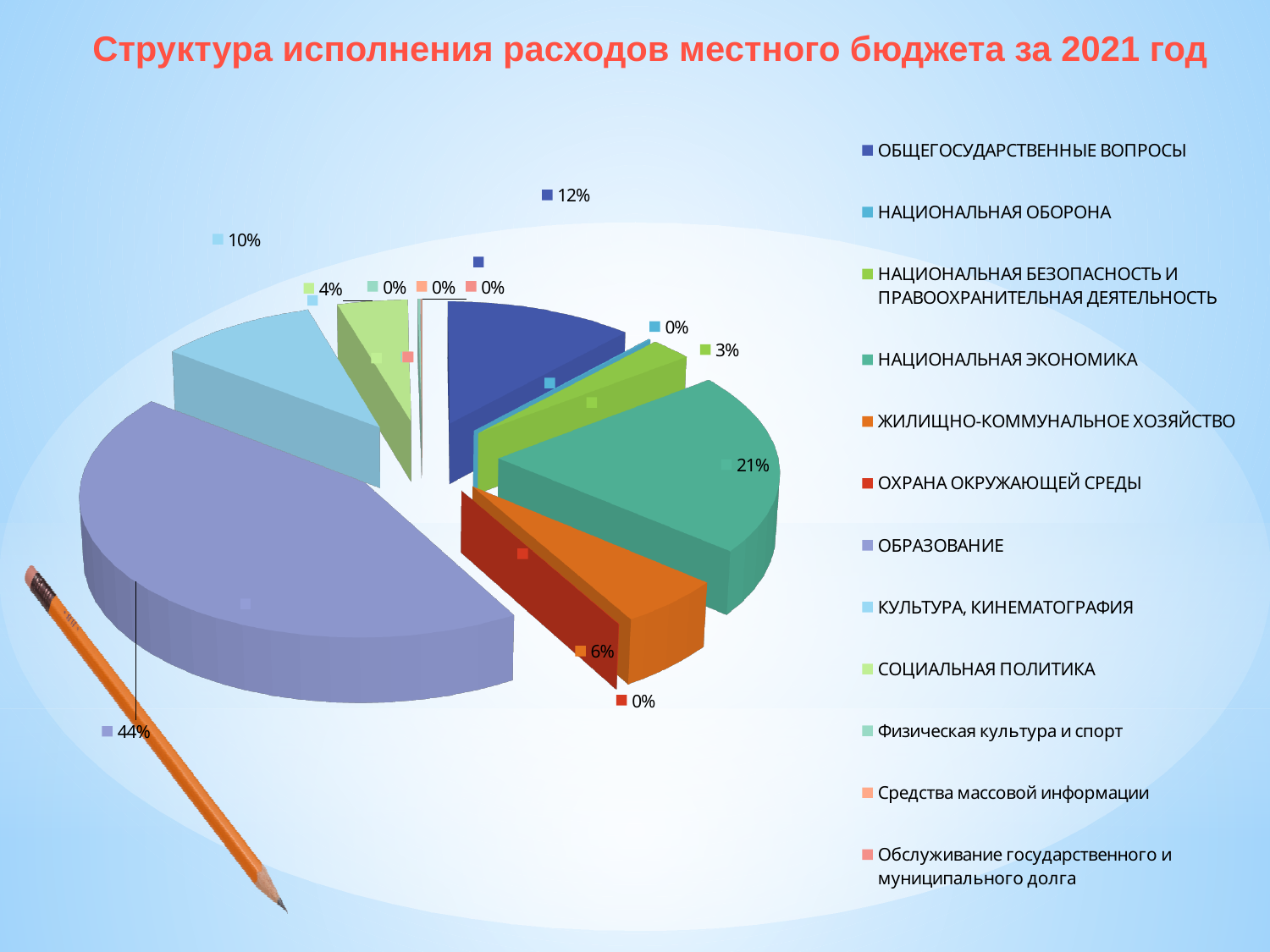
Which category has the largest share of the pie? ОБРАЗОВАНИЕ What kind of chart is shown on the slide? Pie chart What is the difference between the shares of ОБРАЗОВАНИЕ and НАЦИОНАЛЬНАЯ ЭКОНОМИКА? 23% How many categories does the legend list? 12 What percentage is labelled for ОБЩЕГОСУДАРСТВЕННЫЕ ВОПРОСЫ? 12% What is the value for ЖИЛИЩНО-КОММУНАЛЬНОЕ ХОЗЯЙСТВО? 6% What is the value shown for НАЦИОНАЛЬНАЯ ЭКОНОМИКА? 21% What share is shown for КУЛЬТУРА, КИНЕМАТОГРАФИЯ? 10% What share of the pie does ОБРАЗОВАНИЕ account for? 44% What is the value for СОЦИАЛЬНАЯ ПОЛИТИКА? 4% Which is larger, the share for ОБЩЕГОСУДАРСТВЕННЫЕ ВОПРОСЫ or the share for КУЛЬТУРА, КИНЕМАТОГРАФИЯ? ОБЩЕГОСУДАРСТВЕННЫЕ ВОПРОСЫ What is the title of the slide? Структура исполнения расходов местного бюджета за 2021 год